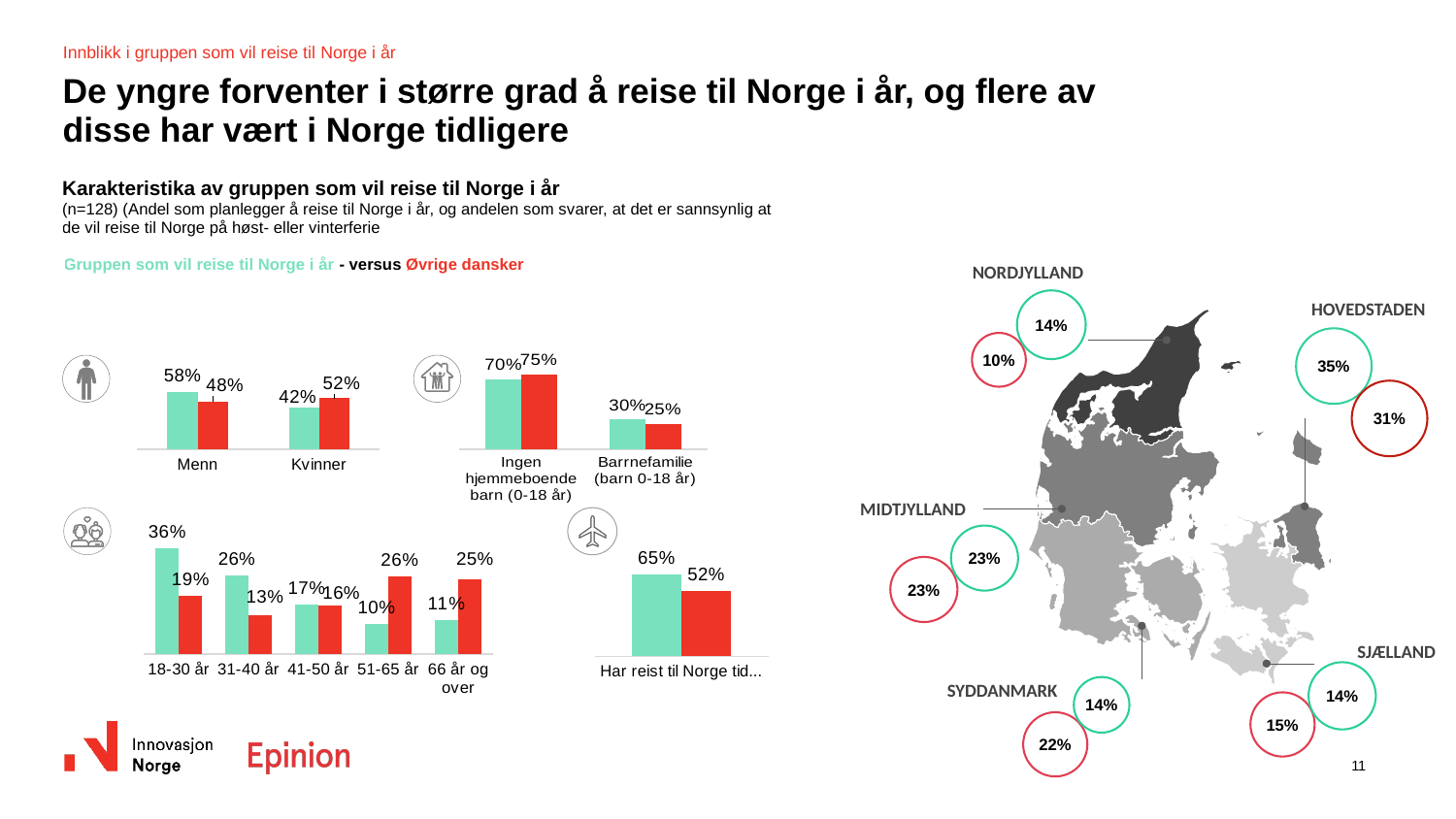
What type of chart is used for the gender comparison (top left)? Bar chart On the map, what is the value shown in the green circle for Hovedstaden? 35% In the children bar chart (top middle), which is larger for 'Ingen hjemmeboende barn (0-18 år)': the green bar or the red bar? The red bar (75%) In the age-group bar chart (bottom left), which age group has the highest value among the group that will travel to Norway this year (green bars)? 18-30 år In the age-group bar chart (bottom left), what is the difference between the green and red bars for 18-30 år? 17 percentage points How many age groups are shown in the age-group bar chart (bottom left)? 5 In the age-group bar chart (bottom left), which age group has the lowest value among Øvrige dansker (red bars)? 31-40 år How many series are compared in the bar charts on the slide? 2 In the bar chart labelled 'Har reist til Norge tid...' (bottom middle), what is the value for the group that will travel to Norway this year (green bar)? 65% In the bar chart labelled 'Har reist til Norge tid...' (bottom middle), what is the difference between the green bar (65%) and the red bar (52%)? 13 percentage points In the age-group bar chart (bottom left), what is the value for 18-30 år in the group that will travel to Norway this year (green bars)? 36% In the gender bar chart (top left), what is the value for Kvinner among Øvrige dansker (red bars)? 52%